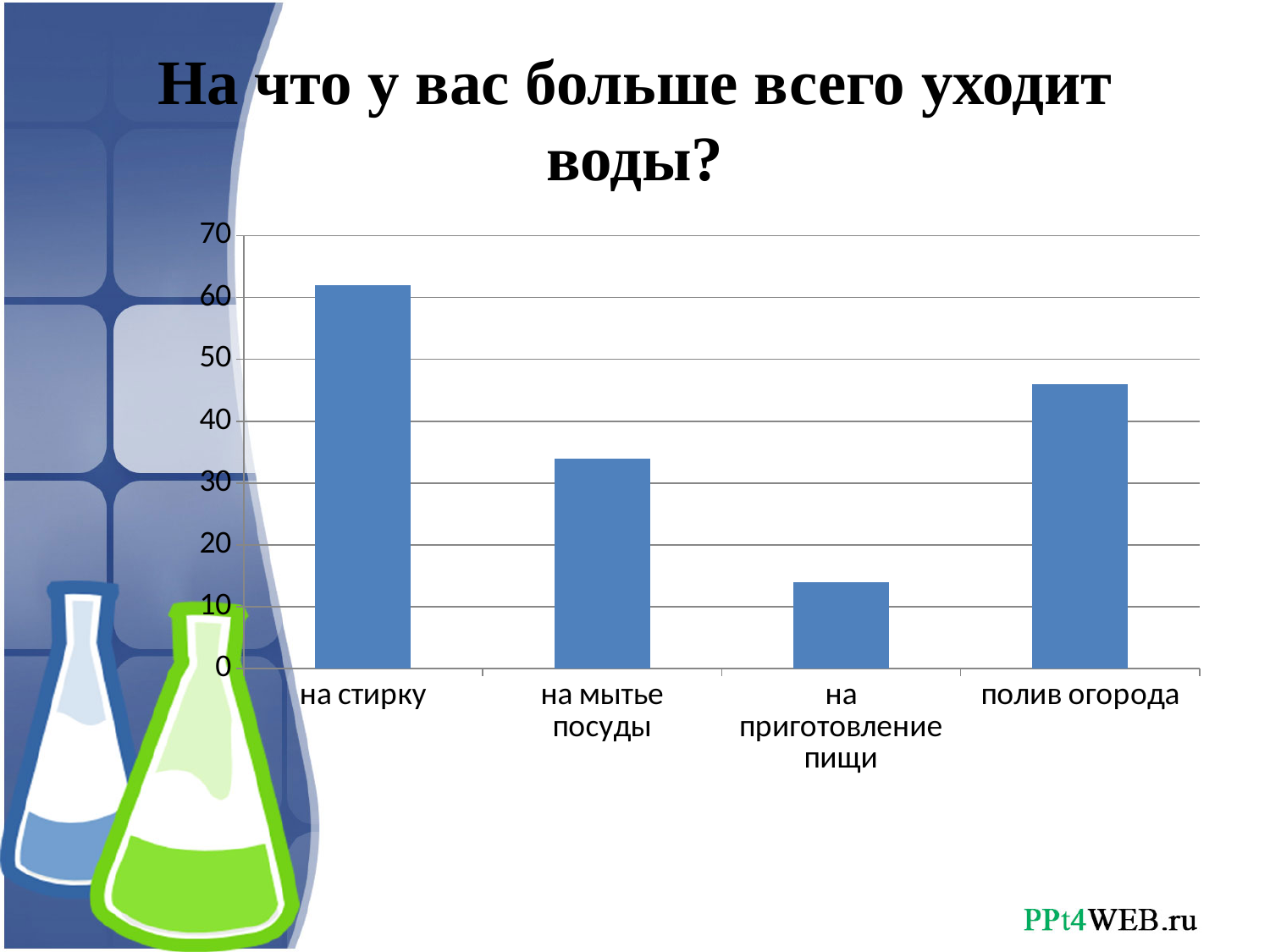
Which is larger, the value for "на стирку" or the value for "полив огорода"? на стирку Which is larger, the value for "полив огорода" or the value for "на мытье посуды"? полив огорода Is the value for "на мытье посуды" greater or less than 40? less What kind of chart is shown on the slide? bar chart Which category has the highest bar in the chart? на стирку How many categories are shown on the x axis of the chart? 4 Is the value for "на стирку" greater or less than 60? greater Is the value for "полив огорода" greater or less than 40? greater Which category has the lowest bar in the chart? на приготовление пищи What is the title of the slide above the chart? На что у вас больше всего уходит воды? What is the highest value shown on the vertical axis of the chart? 70